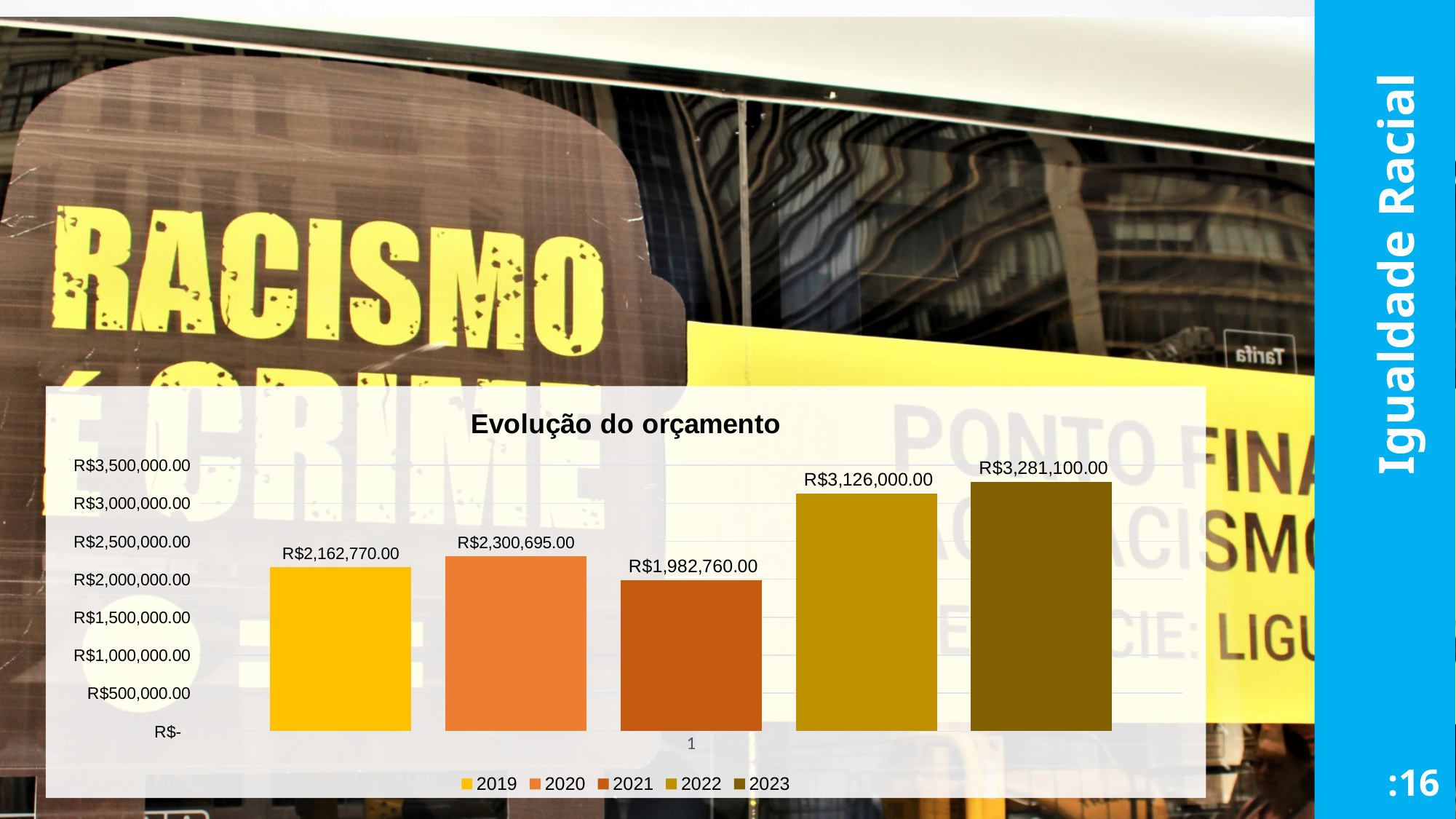
What is the title of the chart? Evolução do orçamento Which year has the lowest value in the chart? 2021 Is the value for 2022 greater or less than R$3,000,000.00? greater What is the value for 2019 in the chart? R$2,162,770.00 How many series does the legend list? 5 What is the value for 2023 in the chart? R$3,281,100.00 What kind of chart is shown on the slide? bar chart Which year has the highest value in the chart? 2023 What is the value for 2021 in the chart? R$1,982,760.00 Which is larger, the value for 2020 or the value for 2021? 2020 What is the difference between the values for 2020 and 2019? R$137,925.00 What is the difference between the values for 2023 and 2022? R$155,100.00